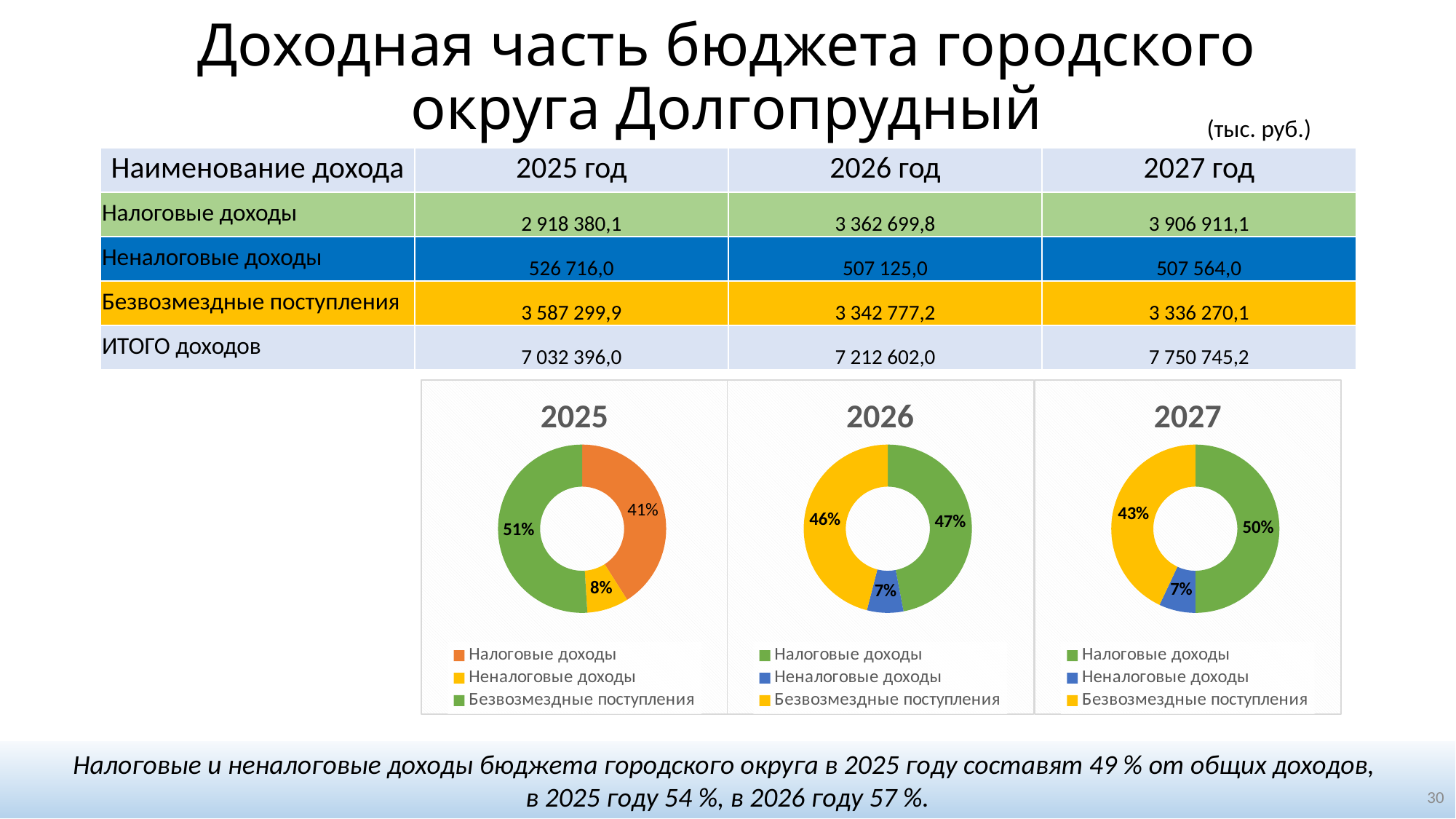
In the 2025 chart, what is the difference in percentage points between Безвозмездные поступления and Налоговые доходы? 10 In the 2027 chart, which category has the largest share? Налоговые доходы In the 2026 chart, what share of the pie is Неналоговые доходы? 7% In the 2025 chart, what share of the pie is Безвозмездные поступления? 51% In the 2026 chart, which category has the smallest share? Неналоговые доходы In the 2025 chart, what share of the pie is Налоговые доходы? 41% In the 2027 chart, which is larger: Налоговые доходы or Безвозмездные поступления? Налоговые доходы What type of chart is used for the 2025, 2026 and 2027 charts? Doughnut (pie) chart In the 2027 chart, what share of the pie is Налоговые доходы? 50% How many slices does the 2026 chart have? 3 In the 2027 chart, what share of the pie is Безвозмездные поступления? 43% In the 2025 chart, which category has the largest share? Безвозмездные поступления